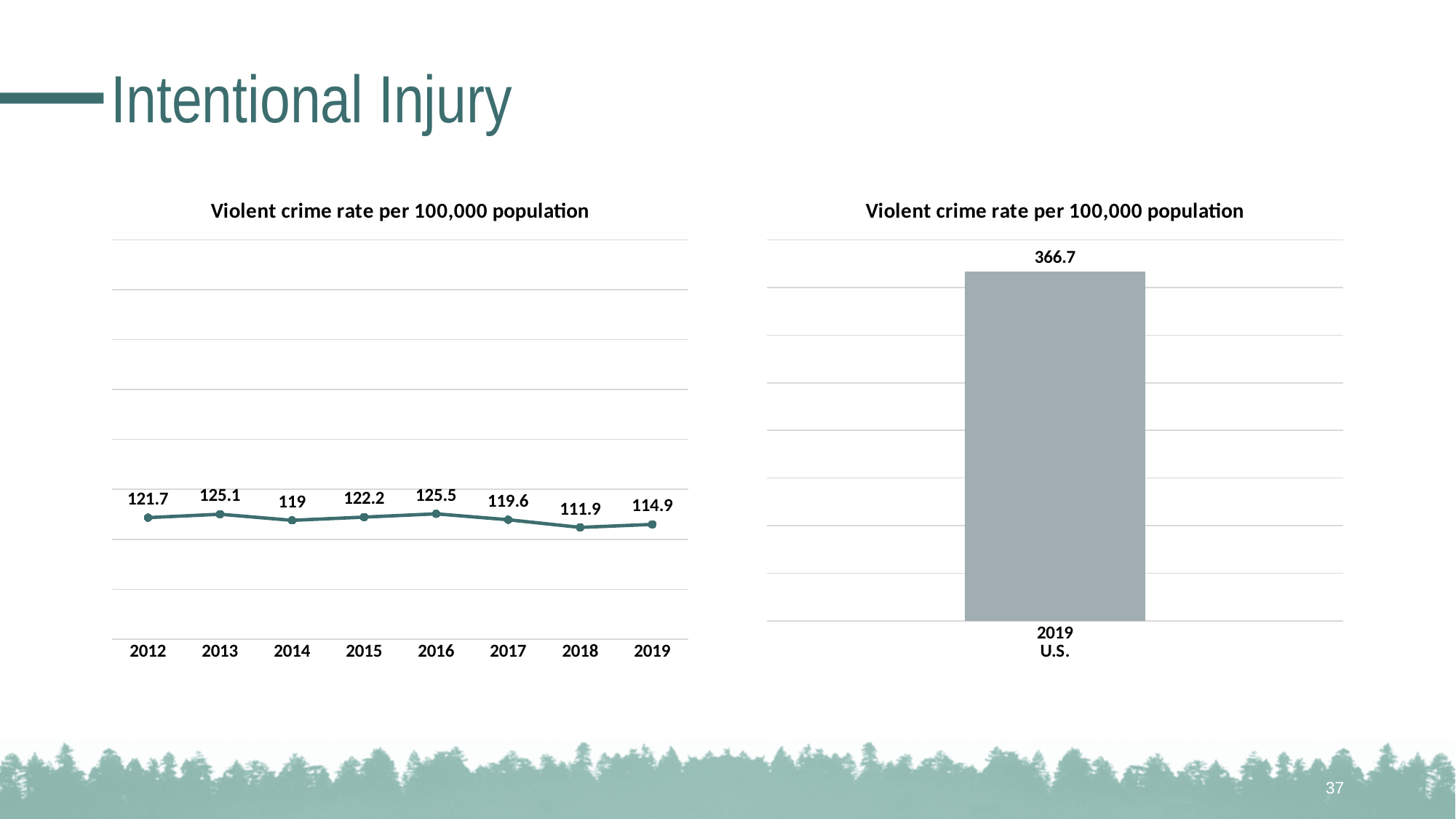
What is the title of the right chart? Violent crime rate per 100,000 population In the right chart, what is the violent crime rate per 100,000 population for 2019 U.S.? 366.7 In the left chart, what is the value for 2014? 119 In the left chart, is the value for 2012 or 2017 larger? 2012 How many years are plotted in the left chart? 8 In the left chart, which year has the lowest violent crime rate? 2018 What kind of chart is the right chart? Bar chart In the left chart, what is the difference between the 2013 value and the 2019 value? 10.2 In the left chart, what is the violent crime rate per 100,000 population in 2018? 111.9 What kind of chart is the left chart? Line chart In the left chart, what is the violent crime rate per 100,000 population in 2016? 125.5 In the left chart, which year has the highest violent crime rate? 2016